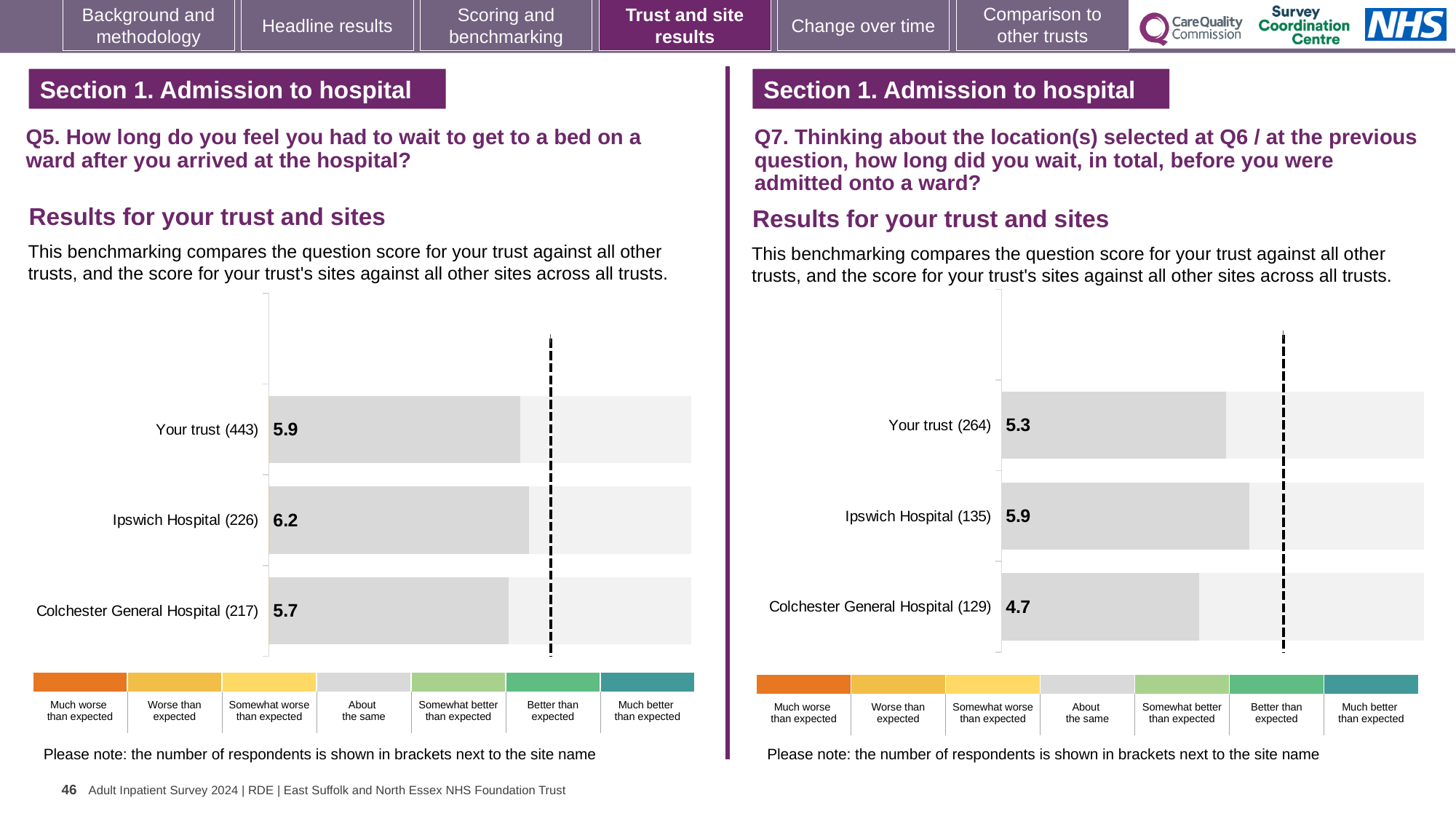
In the Q5 chart on the left, what is the difference between the scores for Ipswich Hospital and Colchester General Hospital? 0.5 In the Q5 chart on the left, what is the score for Your trust? 5.9 In the Q5 chart on the left, how many respondents are shown in brackets for Your trust? 443 In the Q5 chart on the left, which site or trust has the lowest score? Colchester General Hospital How many bars are plotted in the Q7 chart on the right? 3 In the Q7 chart on the right, what is the score for Colchester General Hospital? 4.7 In the Q7 chart on the right, is the score for Your trust larger or smaller than the score for Ipswich Hospital? smaller What type of chart is used in the Q5 chart on the left? bar chart In the Q5 chart on the left, what is the score for Ipswich Hospital? 6.2 In the Q7 chart on the right, what is the difference between the scores for Ipswich Hospital and Colchester General Hospital? 1.2 How many benchmark categories are shown in the colour legend below the Q5 chart on the left? 7 In the Q7 chart on the right, which site or trust has the highest score? Ipswich Hospital